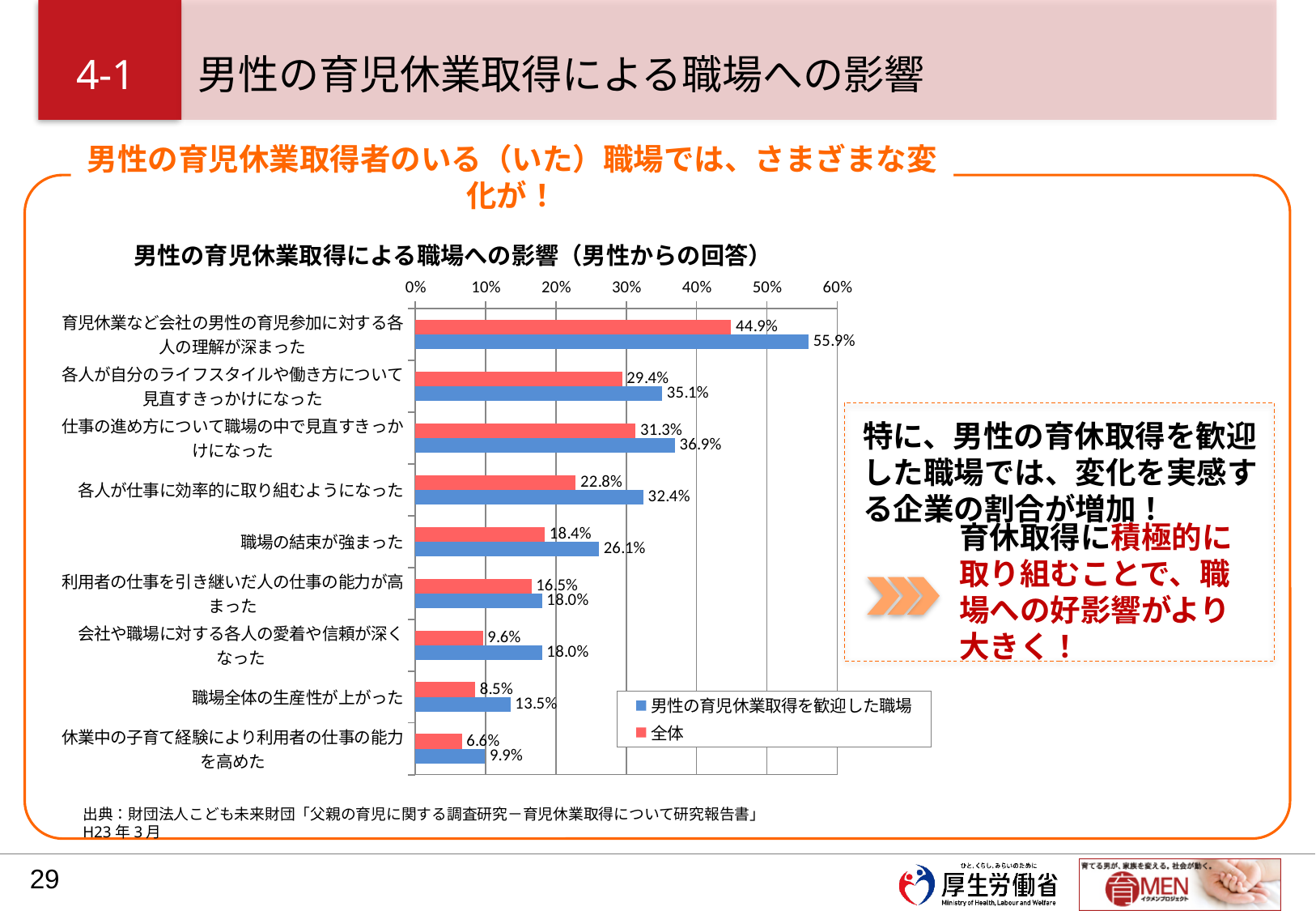
「全体」の系列で最も値が低い項目はどれですか？ 休業中の子育て経験により利用者の仕事の能力を高めた 「各人が仕事に効率的に取り組むようになった」の「男性の育児休業取得を歓迎した職場」の値はいくつですか？ 32.4% このグラフはどの種類のグラフですか？ 棒グラフ 凡例で「全体」の系列は何色で示されていますか？ 赤 「会社や職場に対する各人の愛着や信頼が深くなった」について、「男性の育児休業取得を歓迎した職場」と「全体」ではどちらの値が大きいですか？ 男性の育児休業取得を歓迎した職場 「職場の結束が強まった」の「全体」の値はいくつですか？ 18.4% 凡例にはいくつの系列が示されていますか？ 2 「職場全体の生産性が上がった」の「男性の育児休業取得を歓迎した職場」の値は10%より大きいですか、小さいですか？ 大きい 「男性の育児休業取得を歓迎した職場」の系列で最も値が高い項目はどれですか？ 育児休業など会社の男性の育児参加に対する各人の理解が深まった グラフのタイトルは何ですか？ 男性の育児休業取得による職場への影響（男性からの回答） 「育児休業など会社の男性の育児参加に対する各人の理解が深まった」について、「男性の育児休業取得を歓迎した職場」と「全体」の差は何ポイントですか？ 11.0ポイント グラフにはいくつの項目（カテゴリ）がありますか？ 9